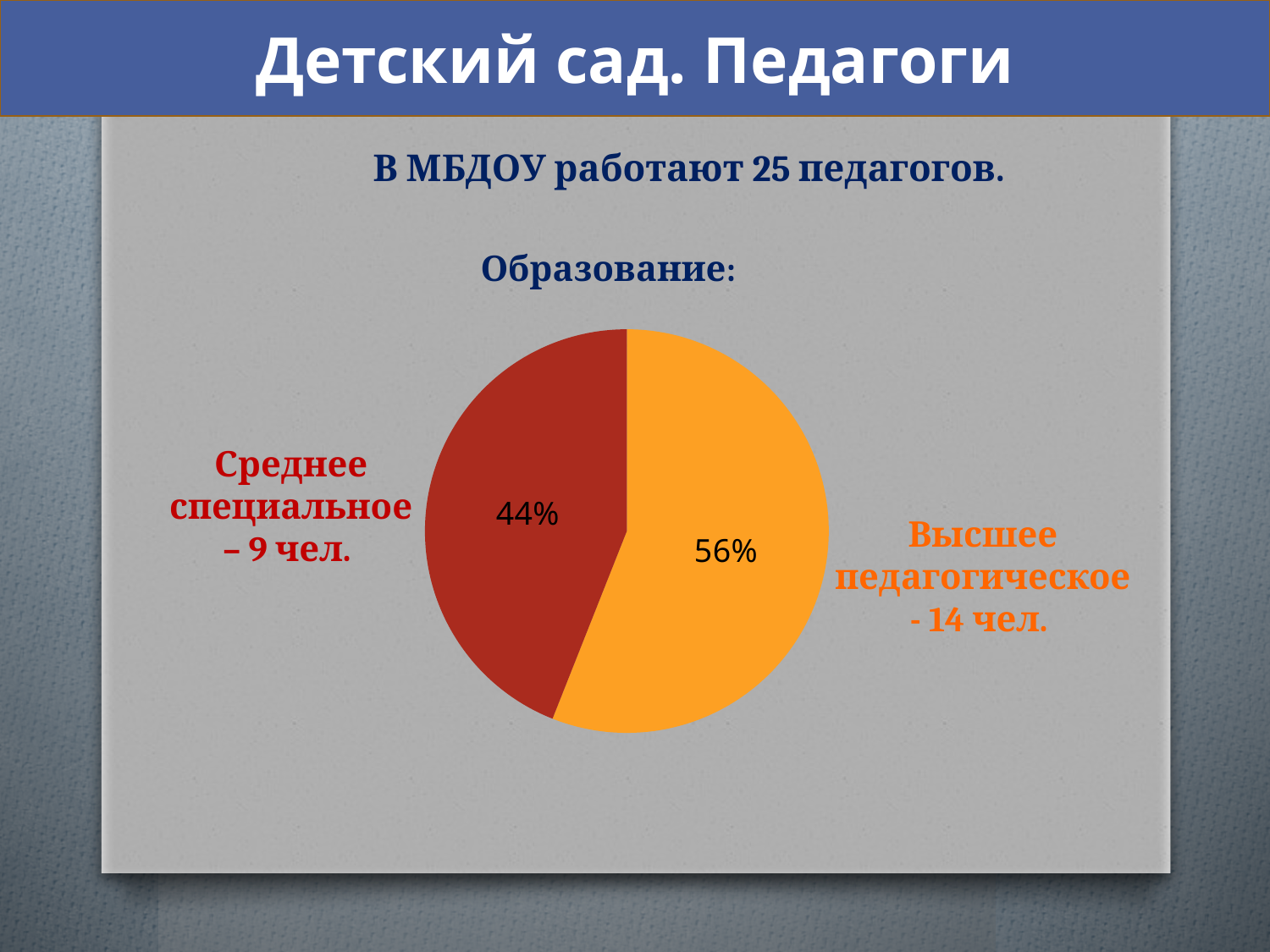
What kind of chart is shown on the slide? Pie chart Which category has the smallest slice of the pie? Среднее специальное How many slices does the pie chart have? 2 How many teachers have "Среднее специальное" education according to the slide? 9 чел. Which category has the largest slice of the pie? Высшее педагогическое How many teachers have "Высшее педагогическое" education according to the slide? 14 чел. What is the difference in percentage points between the "Высшее педагогическое" and "Среднее специальное" slices? 12 What is the title of the chart? Образование: What share of the pie does the "Высшее педагогическое" slice represent? 56% Which slice is larger: "Среднее специальное" or "Высшее педагогическое"? Высшее педагогическое What share of the pie does the "Среднее специальное" slice represent? 44% What colour is the "Среднее специальное" slice? Red